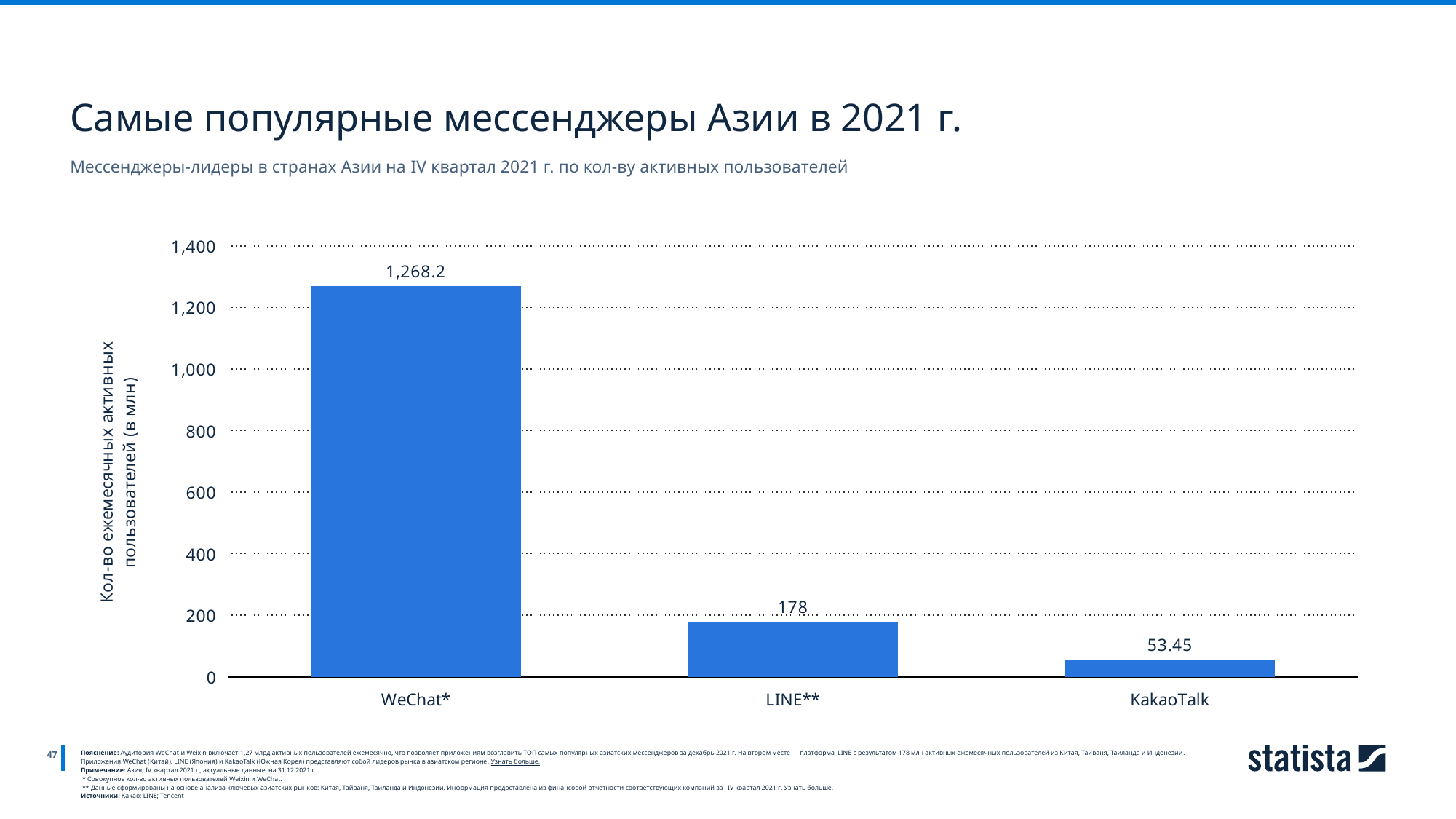
How many messengers are shown in the chart? 3 Is the value for WeChat* greater or less than 1,200? greater Which messenger has the lowest number of monthly active users? KakaoTalk What is the value for LINE**? 178 What kind of chart is shown on the slide? bar chart Which messenger has the highest number of monthly active users? WeChat* What is the difference between the values for WeChat* and LINE**? 1,090.2 What is the title of the slide? Самые популярные мессенджеры Азии в 2021 г. What is the value for WeChat*? 1,268.2 What is the difference between the values for LINE** and KakaoTalk? 124.55 Which is larger, the value for LINE** or the value for KakaoTalk? LINE** What is the value for KakaoTalk? 53.45